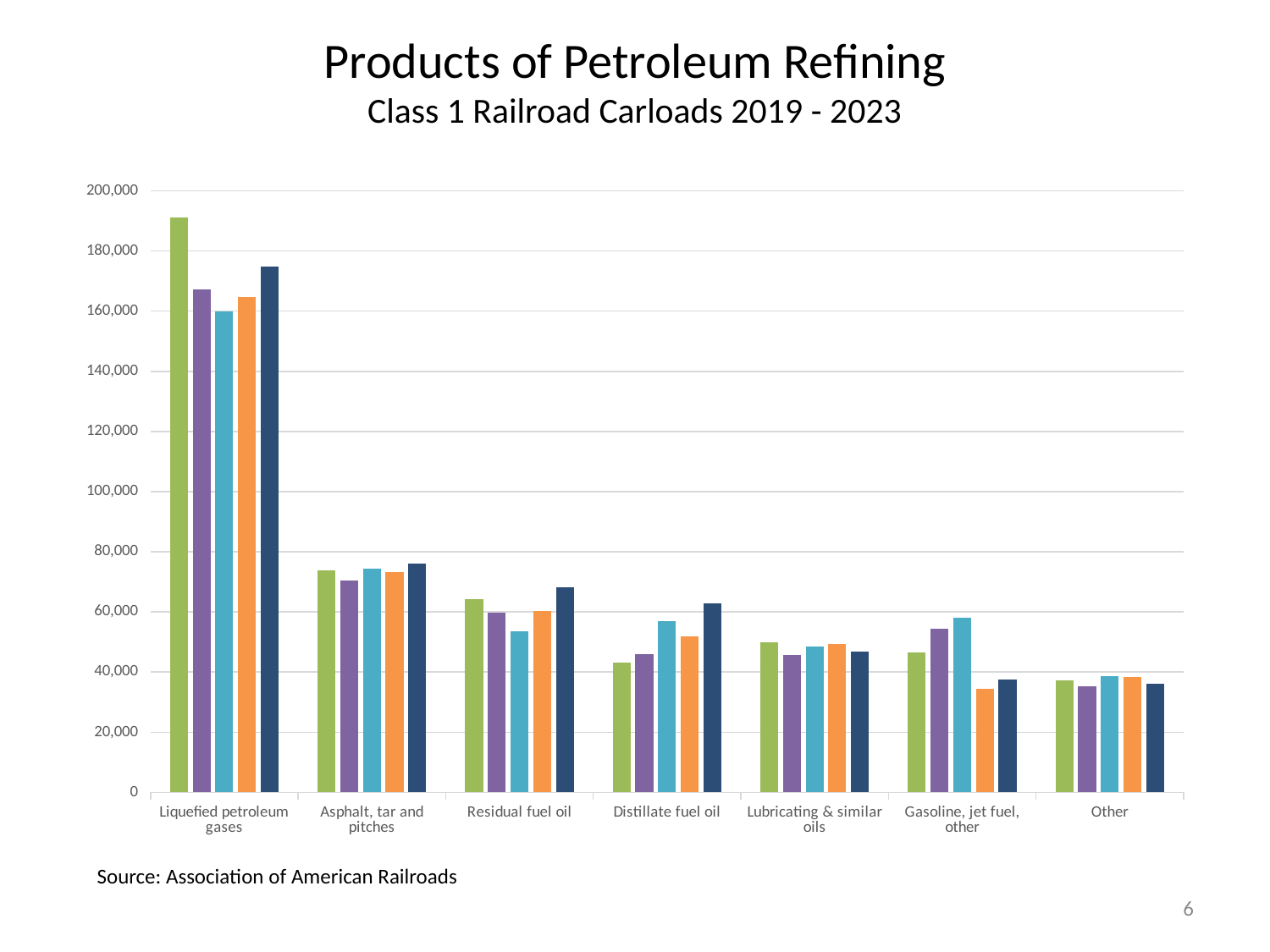
For Residual fuel oil, which is larger: the dark blue (last) bar or the teal (third) bar? the dark blue (last) bar How many product categories are shown on the x axis? 7 How many bars are plotted for each product category? 5 What kind of chart is shown on the slide? bar chart What is the title of the chart? Products of Petroleum Refining Which product category has the tallest bars? Liquefied petroleum gases Is the value of the green (first) bar for Liquefied petroleum gases greater or less than 180,000? greater Is the tallest bar for Other greater or less than 40,000? less For Liquefied petroleum gases, which is larger: the green (first) bar or the dark blue (last) bar? the green (first) bar Is the value of the teal (third) bar for Gasoline, jet fuel, other greater or less than 50,000? greater